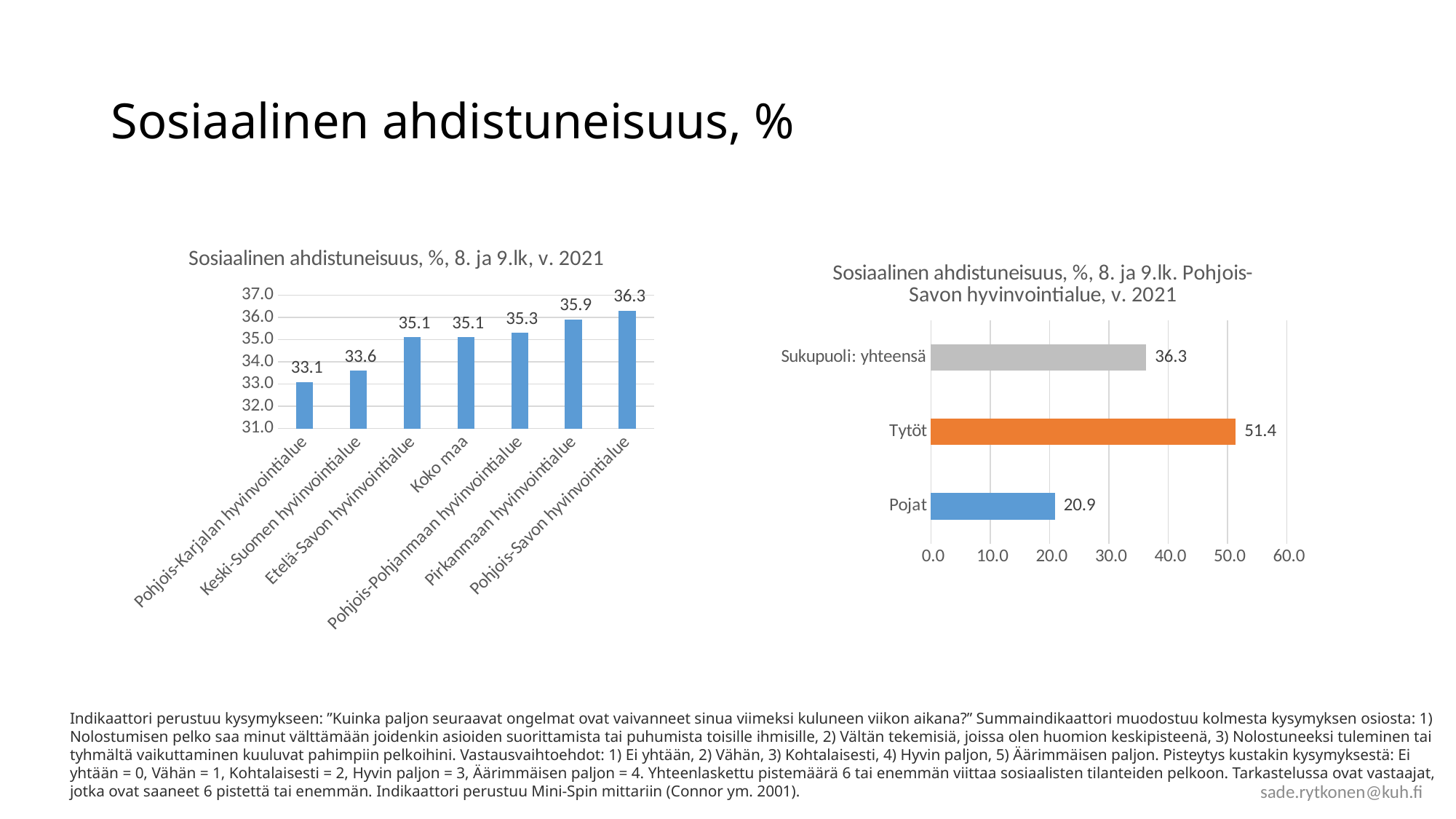
In the left chart (Sosiaalinen ahdistuneisuus, %, 8. ja 9.lk, v. 2021), how many categories are shown? 7 In the right chart (Pohjois-Savon hyvinvointialue), what is the value for Tytöt? 51.4 In the left chart (Sosiaalinen ahdistuneisuus, %, 8. ja 9.lk, v. 2021), which category has the lowest value? Pohjois-Karjalan hyvinvointialue In the left chart (Sosiaalinen ahdistuneisuus, %, 8. ja 9.lk, v. 2021), what is the difference between Pohjois-Savon hyvinvointialue and Pohjois-Karjalan hyvinvointialue? 3.2 In the right chart (Pohjois-Savon hyvinvointialue), what is the value for Pojat? 20.9 In the left chart (Sosiaalinen ahdistuneisuus, %, 8. ja 9.lk, v. 2021), what is the value for Koko maa? 35.1 What kind of chart is the right chart (Pohjois-Savon hyvinvointialue)? bar chart In the left chart (Sosiaalinen ahdistuneisuus, %, 8. ja 9.lk, v. 2021), which category has the highest value? Pohjois-Savon hyvinvointialue In the left chart (Sosiaalinen ahdistuneisuus, %, 8. ja 9.lk, v. 2021), do the values rise or fall from left to right? rise In the right chart (Pohjois-Savon hyvinvointialue), what is the difference between Tytöt and Pojat? 30.5 In the left chart (Sosiaalinen ahdistuneisuus, %, 8. ja 9.lk, v. 2021), what is the value for Pirkanmaan hyvinvointialue? 35.9 In the right chart (Pohjois-Savon hyvinvointialue), which is larger, Tytöt or Sukupuoli: yhteensä? Tytöt